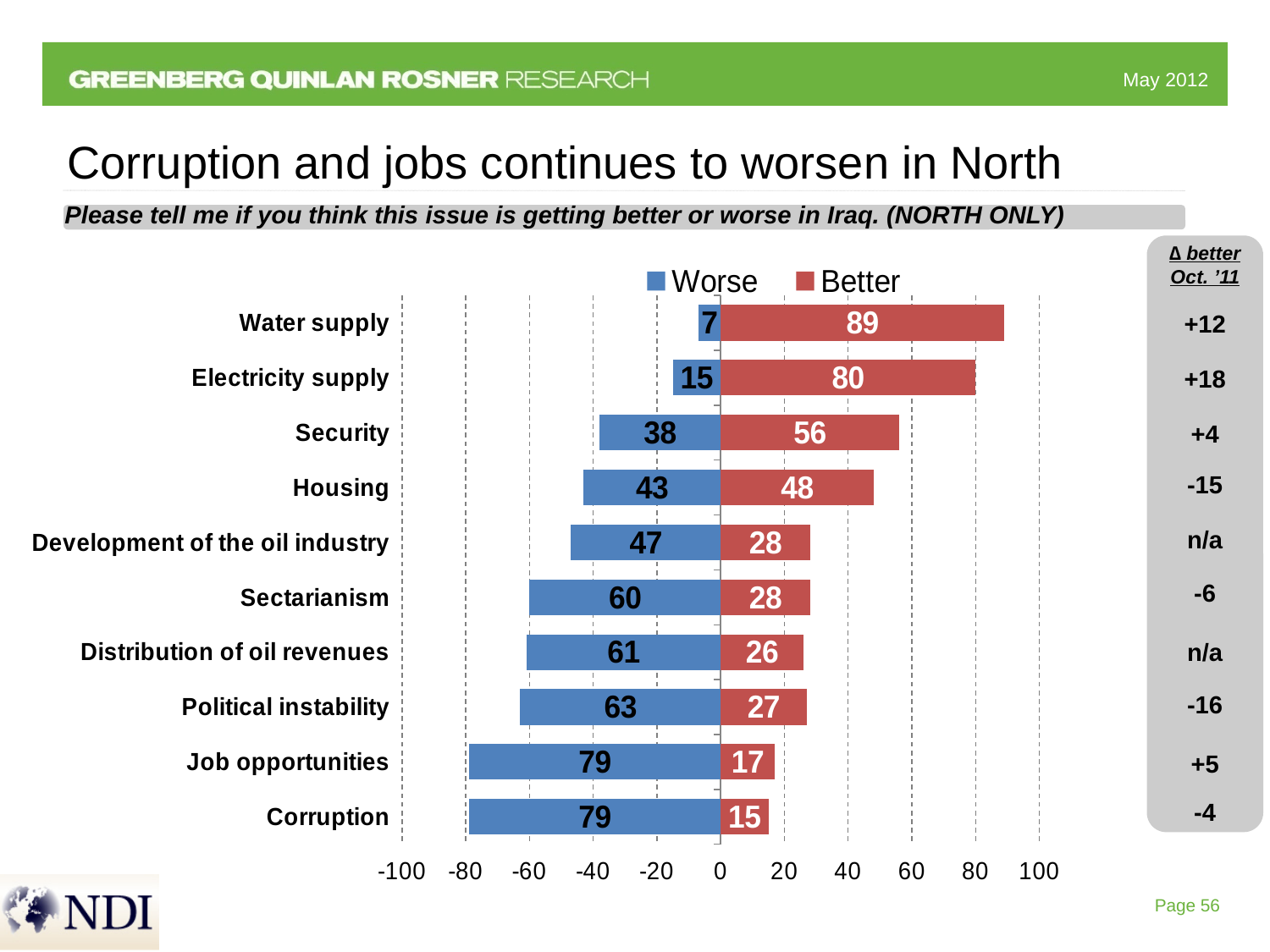
How many categories are shown in the chart? 10 What is the 'Worse' value for Security? 38 What is the 'Worse' value for Political instability? 63 What kind of chart is shown on the slide? Bar chart Which category has the lowest 'Better' value? Corruption Which category has the lowest 'Worse' value? Water supply Which colour represents the 'Worse' series in the chart? Blue What is the difference between the 'Better' and 'Worse' values for Housing? 5 Which category has the highest 'Better' value? Water supply How many series does the legend list? 2 What is the 'Better' value for Water supply? 89 Which is larger for Electricity supply, the 'Worse' value or the 'Better' value? Better